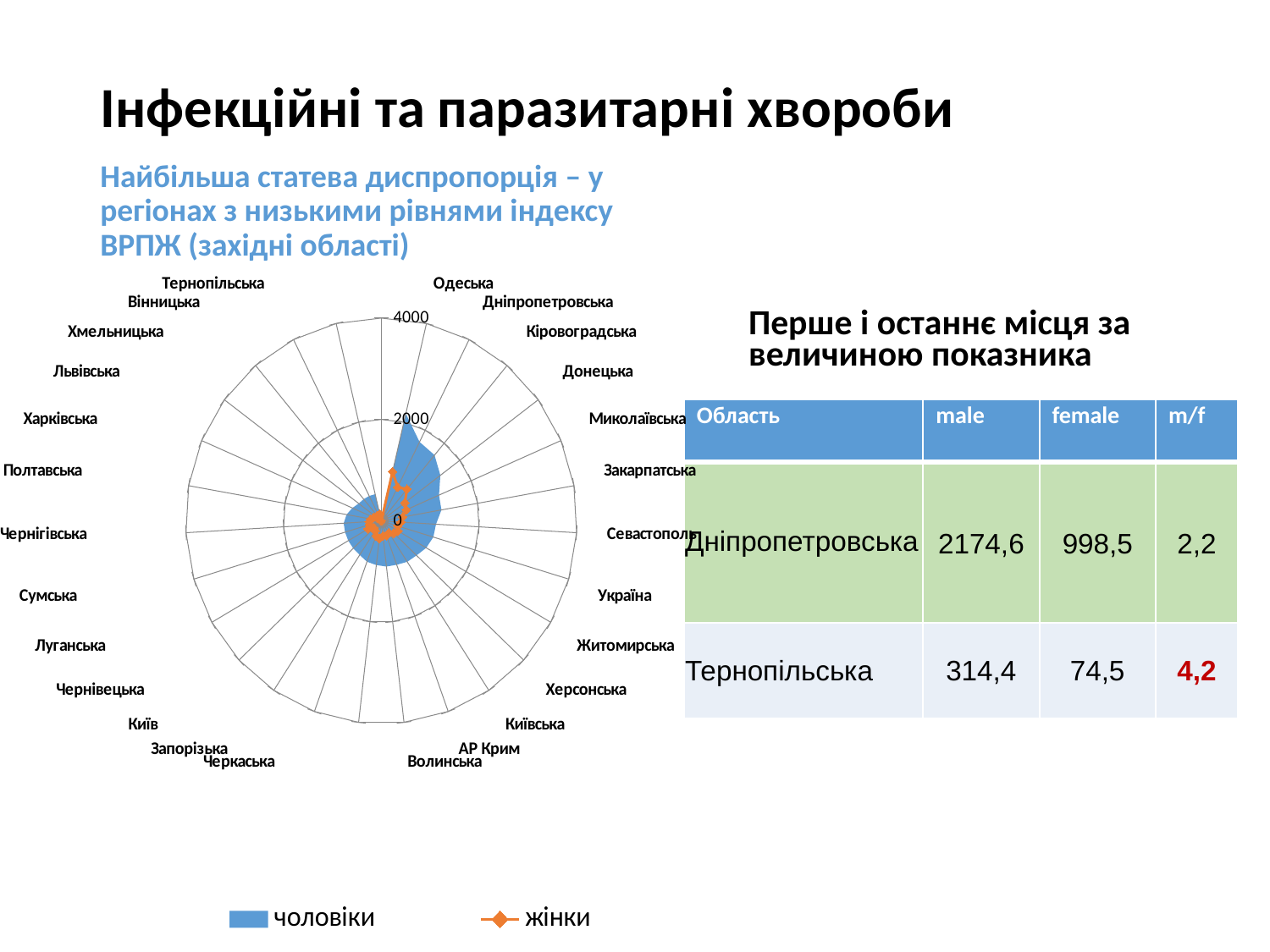
What are the two series named in the chart's legend? чоловіки and жінки Is the жінки value for Дніпропетровська on the chart greater or less than 2000? less How many series does the chart's legend list? 2 Is the чоловіки value for Одеська on the chart greater or less than 4000? less On the chart, which series has the larger value for Дніпропетровська, чоловіки or жінки? чоловіки What kind of chart is shown on the slide? radar chart Is the чоловіки value for Тернопільська on the chart greater or less than 2000? less What is the highest value shown on the chart's radial axis? 4000 Which series is drawn as a filled blue area on the chart? чоловіки